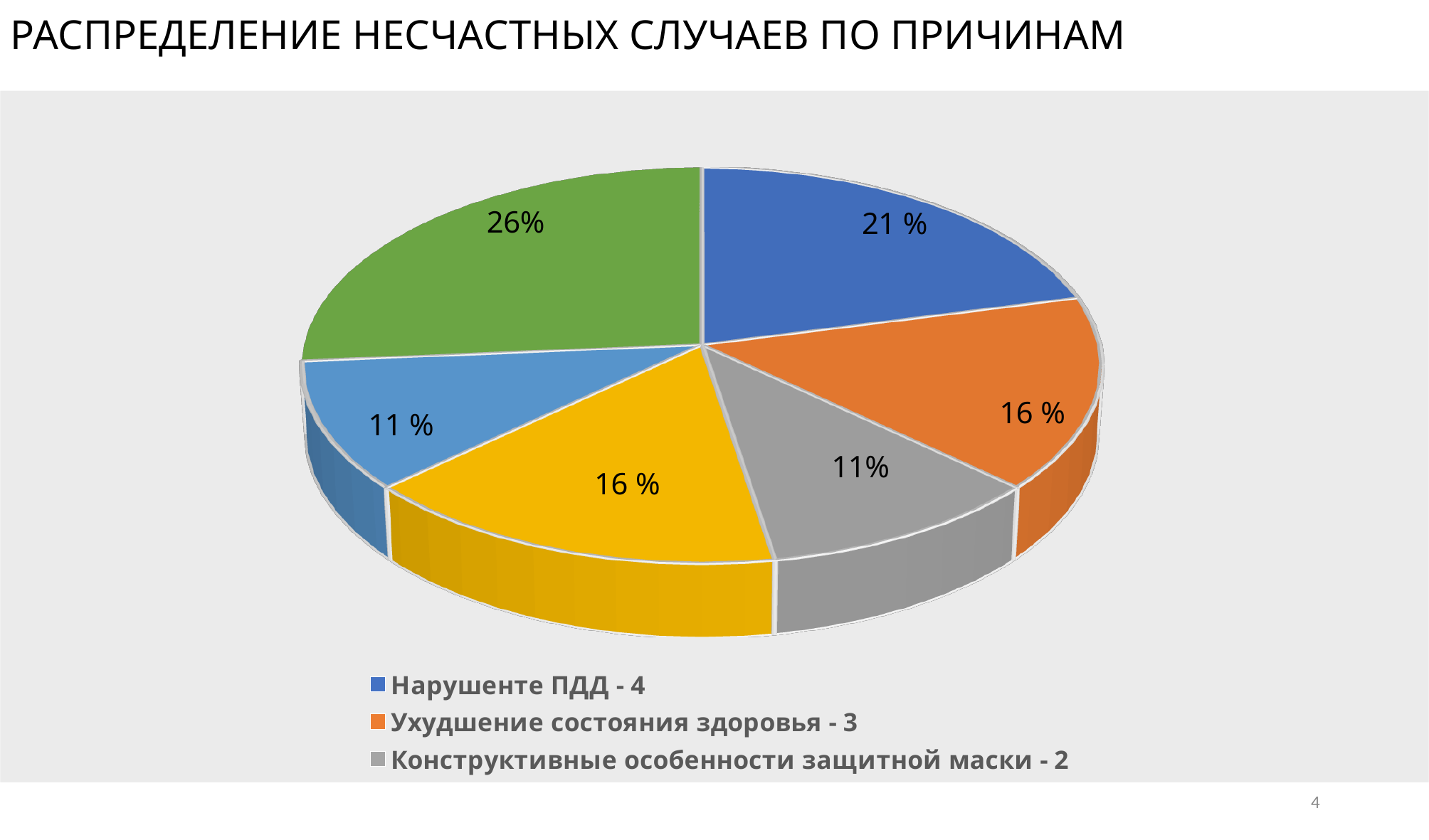
What kind of chart is shown on the slide? Pie chart What is the largest percentage shown on the pie chart? 26% By how many percentage points does the 'Нарушенте ПДД - 4' slice exceed the 'Ухудшение состояния здоровья - 3' slice? 5 Which slice is larger: 'Нарушенте ПДД - 4' or 'Ухудшение состояния здоровья - 3'? Нарушенте ПДД - 4 What percentage is shown for the slice labelled 'Нарушенте ПДД - 4'? 21 % How many entries does the legend list? 3 What percentage is shown for the slice labelled 'Ухудшение состояния здоровья - 3'? 16 % What is the smallest percentage shown on the pie chart? 11% How many slices does the pie chart have? 6 What percentage is shown for the slice labelled 'Конструктивные особенности защитной маски - 2'? 11% What is the title of the slide? РАСПРЕДЕЛЕНИЕ НЕСЧАСТНЫХ СЛУЧАЕВ ПО ПРИЧИНАМ Which colour is the largest slice of the pie chart? Green